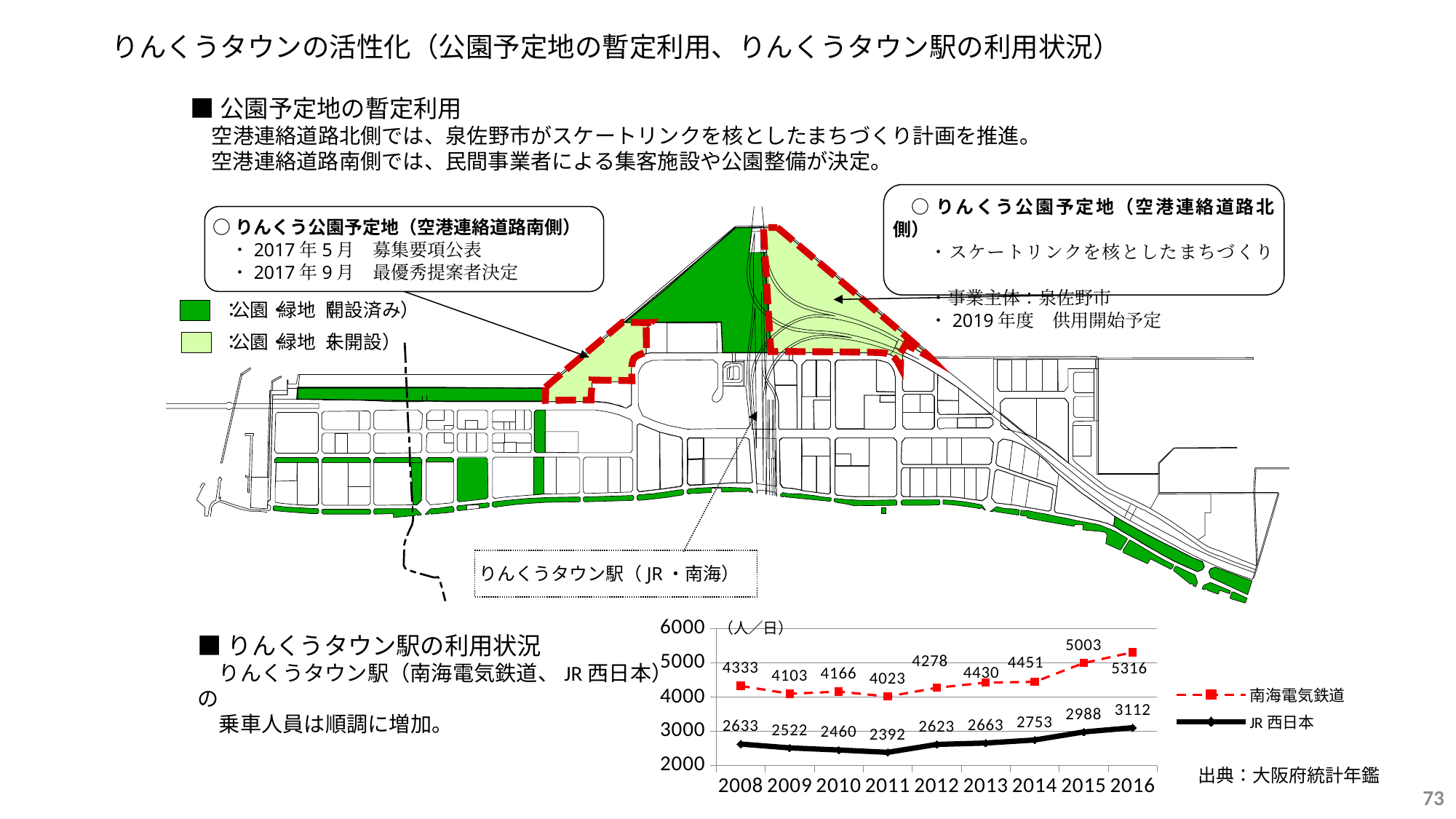
What is the difference between the 南海電気鉄道 values in 2016 and 2015? 313 What is the value for 南海電気鉄道 in 2008? 4333 In which year is the value for JR西日本 lowest? 2011 What is the value for JR西日本 in 2011? 2392 What unit is shown at the top of the line chart's y axis? 人／日 How many years are plotted on the x axis of the line chart? 9 In which year is the value for 南海電気鉄道 highest? 2016 How many series does the legend of the line chart list? 2 What is the difference between the 南海電気鉄道 and JR西日本 values in 2012? 1655 Which series has the larger value in 2014, 南海電気鉄道 or JR西日本? 南海電気鉄道 What is the value for 南海電気鉄道 in 2016? 5316 What type of chart is shown at the bottom of the slide? line chart